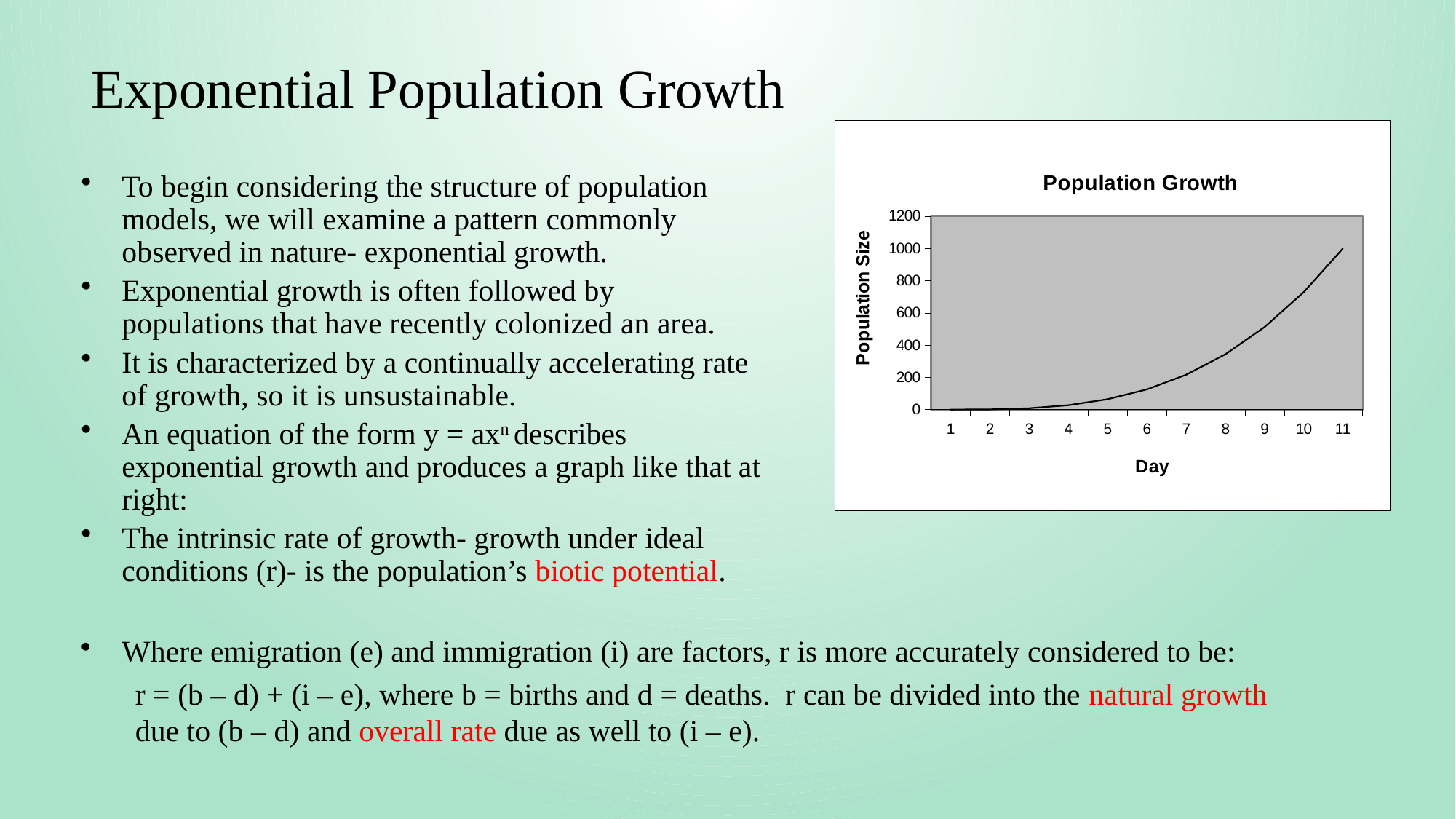
Do the values in the chart rise or fall as the day increases? rise On which day is the population size highest? 11 Is the population size on day 6 greater or less than 200? less Which has the larger population size, day 5 or day 10? day 10 Is the population size on day 10 greater or less than 600? greater Is the population size on day 11 greater or less than 800? greater What is the title of the chart? Population Growth What kind of chart is shown on the slide? line chart How many days are plotted along the x axis of the chart? 11 What is the label of the x axis of the chart? Day On which day is the population size lowest? 1